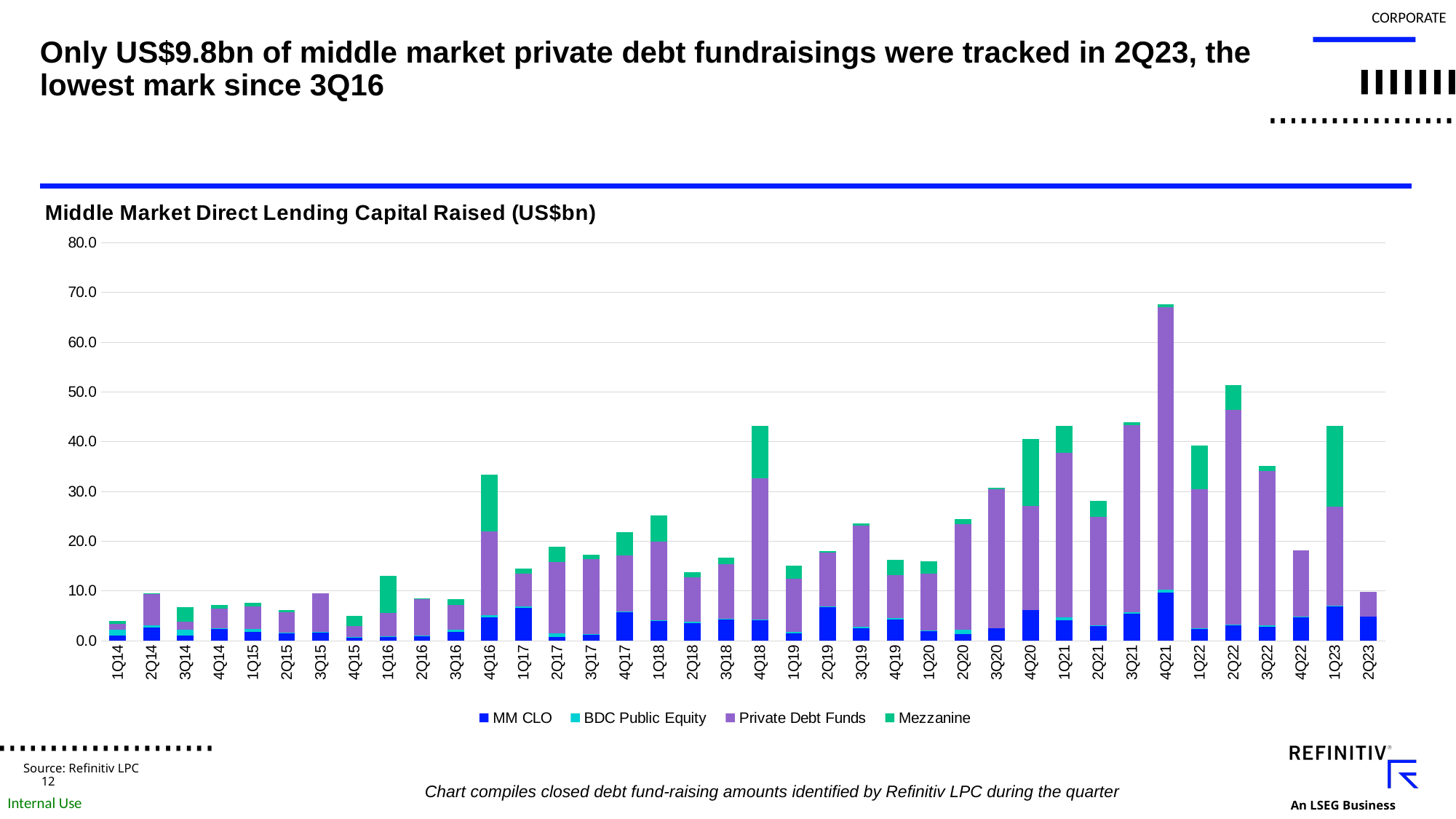
Is the total value for 4Q22 greater or less than 20.0? less What is the title of the chart? Middle Market Direct Lending Capital Raised (US$bn) Is the total value for 4Q21 greater or less than 60.0? greater How many quarters are plotted along the x axis? 38 Is the total value for 2Q21 greater or less than 30.0? less Which quarter has a larger total, 4Q21 or 2Q22? 4Q21 Which quarter has the lowest total capital raised? 1Q14 Which quarter has a larger total, 1Q23 or 2Q23? 1Q23 How many series does the legend list? 4 What kind of chart is shown on the slide? Stacked bar chart Which quarter has the highest total capital raised? 4Q21